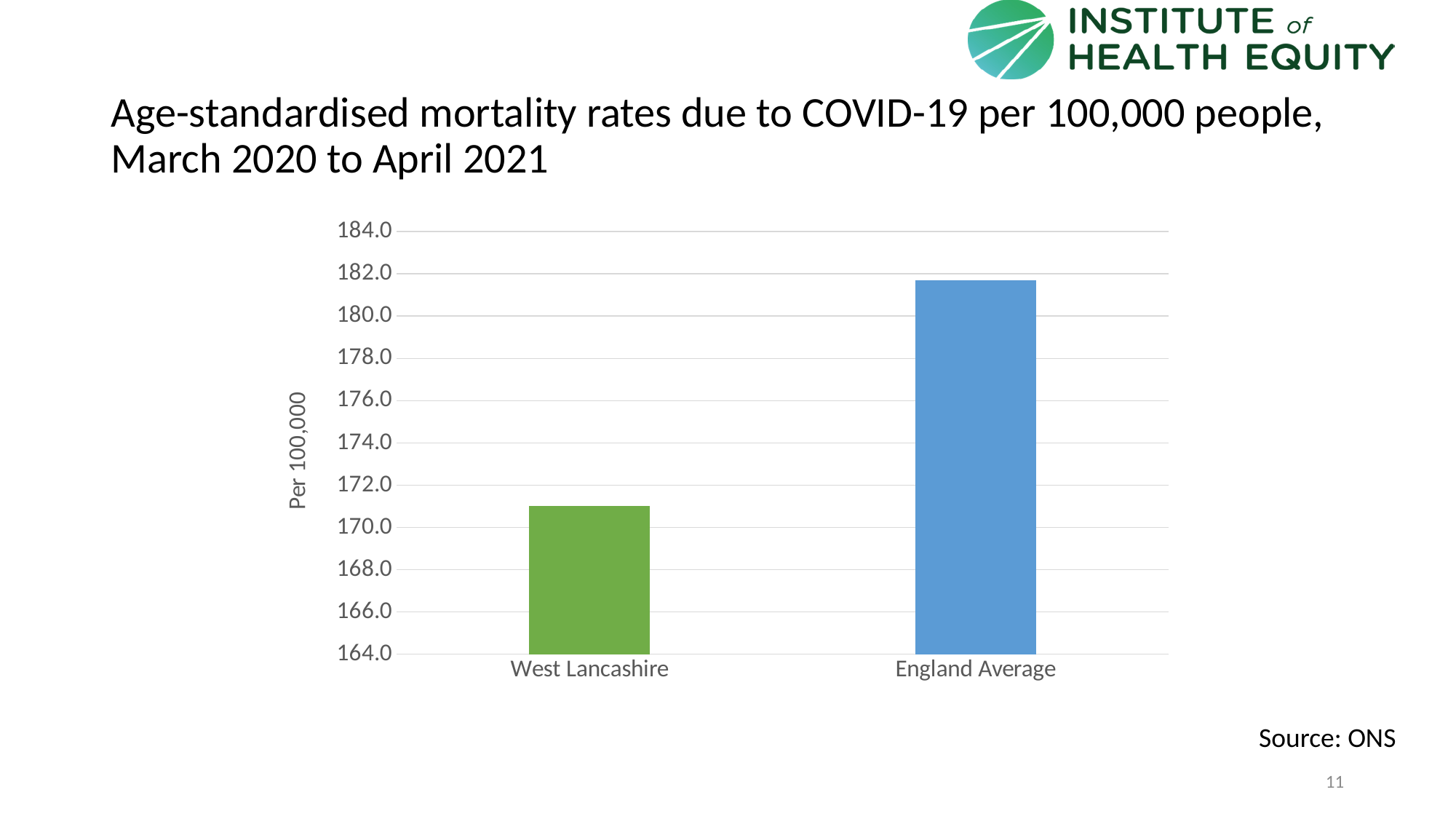
Is the value for England Average greater or less than 180.0? greater What is the source cited for the chart data? ONS Which is larger, the mortality rate for West Lancashire or for England Average? England Average Is the value for West Lancashire greater or less than 172.0? less Is the value for England Average greater or less than 182.0? less Which category has the highest age-standardised COVID-19 mortality rate? England Average How many bars does the chart show? 2 What kind of chart is shown on the slide? bar chart What is the label on the vertical axis of the chart? Per 100,000 Which category has the lowest age-standardised COVID-19 mortality rate? West Lancashire What is the lowest value shown on the vertical axis? 164.0